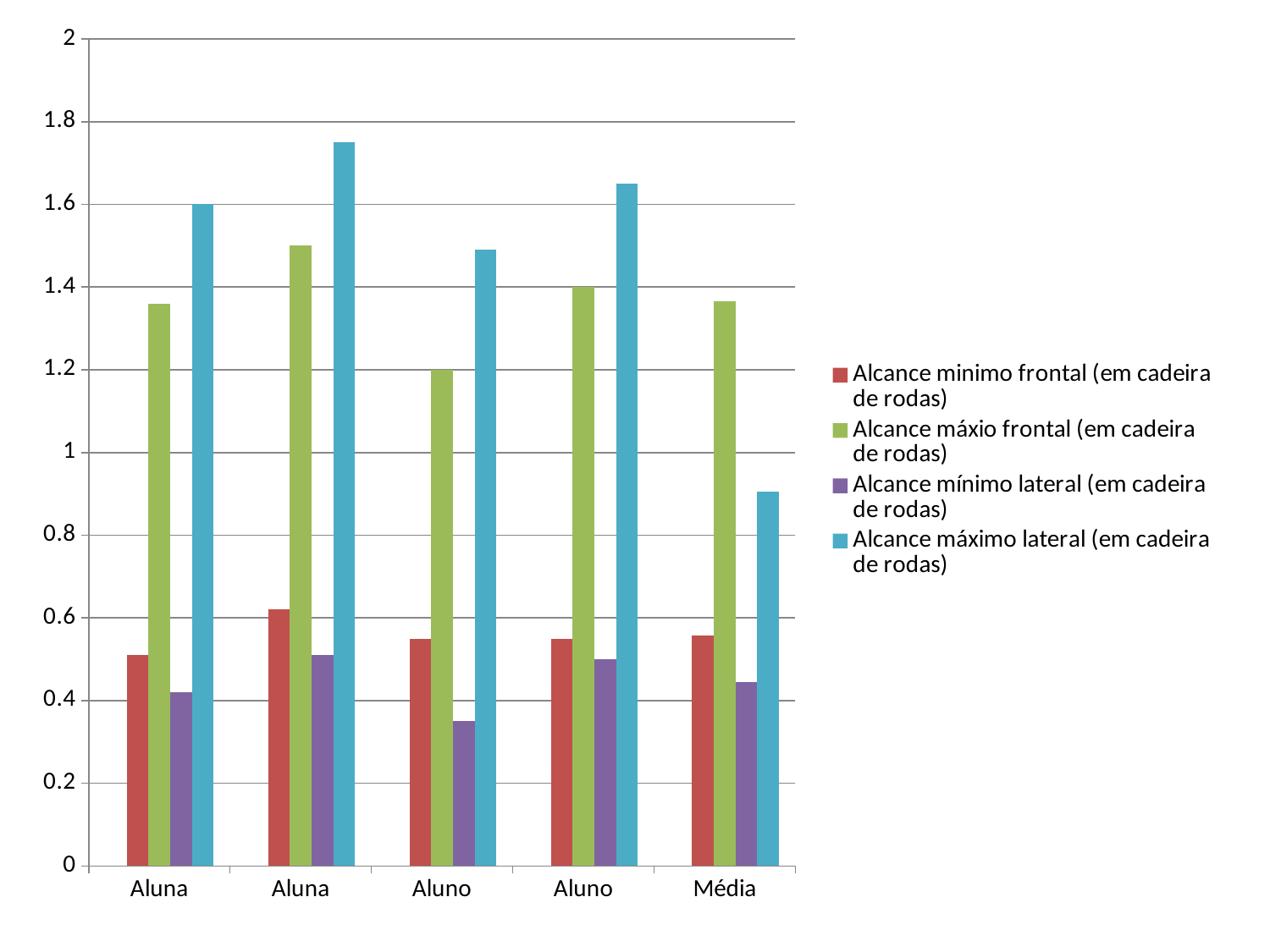
Is the value of Alcance máximo lateral (em cadeira de rodas) for the second Aluna greater or less than 1.6? greater Which category has the lowest value for Alcance mínimo lateral (em cadeira de rodas)? the first Aluno What is the value of Alcance máxio frontal (em cadeira de rodas) for the first Aluno category? 1.2 What kind of chart is shown on the slide? bar chart What is the value of Alcance máxio frontal (em cadeira de rodas) for the second Aluno category? 1.4 Is the value of Alcance máximo lateral (em cadeira de rodas) for Média greater or less than 1? less Which series is shown in blue in the legend? Alcance máximo lateral (em cadeira de rodas) How many series does the legend list? 4 Which is larger: Alcance máxio frontal (em cadeira de rodas) for the first Aluna or for the second Aluna? the second Aluna How many categories are shown on the x axis? 5 Which category has the highest value for Alcance máximo lateral (em cadeira de rodas)? the second Aluna What is the value of Alcance máximo lateral (em cadeira de rodas) for the first Aluna category? 1.6